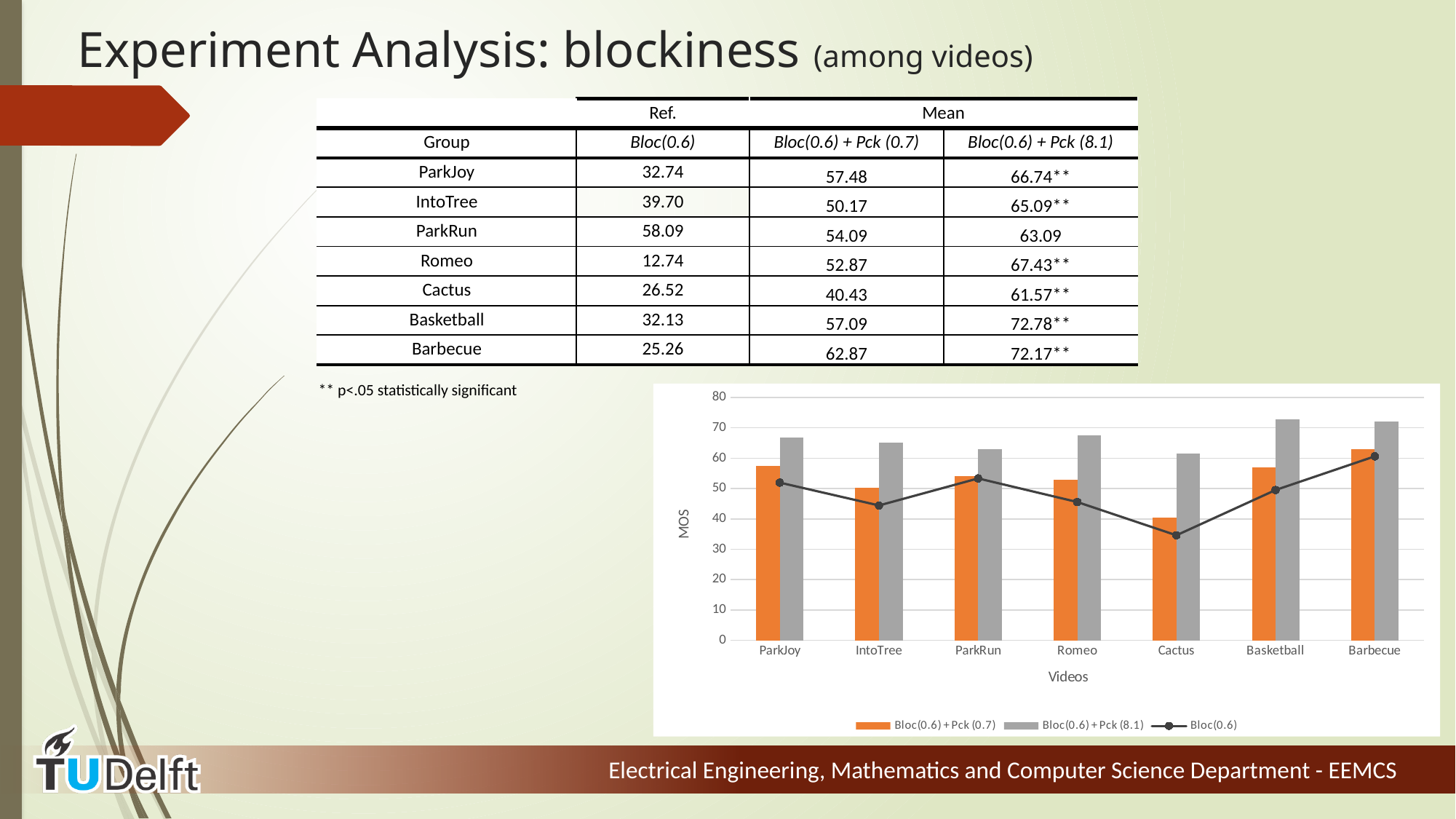
What kind of chart is shown on the slide? bar chart (with a line series) What is the label of the y axis of the chart? MOS Which video has the highest Bloc(0.6) + Pck (0.7) bar? Barbecue Is the Bloc(0.6) line value for Romeo greater or less than 50? less Is the Bloc(0.6) + Pck (8.1) value for Basketball greater or less than 70? greater Is the Bloc(0.6) + Pck (0.7) value for Cactus greater or less than 50? less Which series is drawn as a line in the chart? Bloc(0.6) How many series does the chart legend list? 3 Which video has the lowest point on the Bloc(0.6) line? Cactus Which video has the lowest Bloc(0.6) + Pck (0.7) bar? Cactus For Cactus, which is larger: the Bloc(0.6) + Pck (0.7) bar or the Bloc(0.6) + Pck (8.1) bar? Bloc(0.6) + Pck (8.1) How many videos are shown along the x axis of the chart? 7